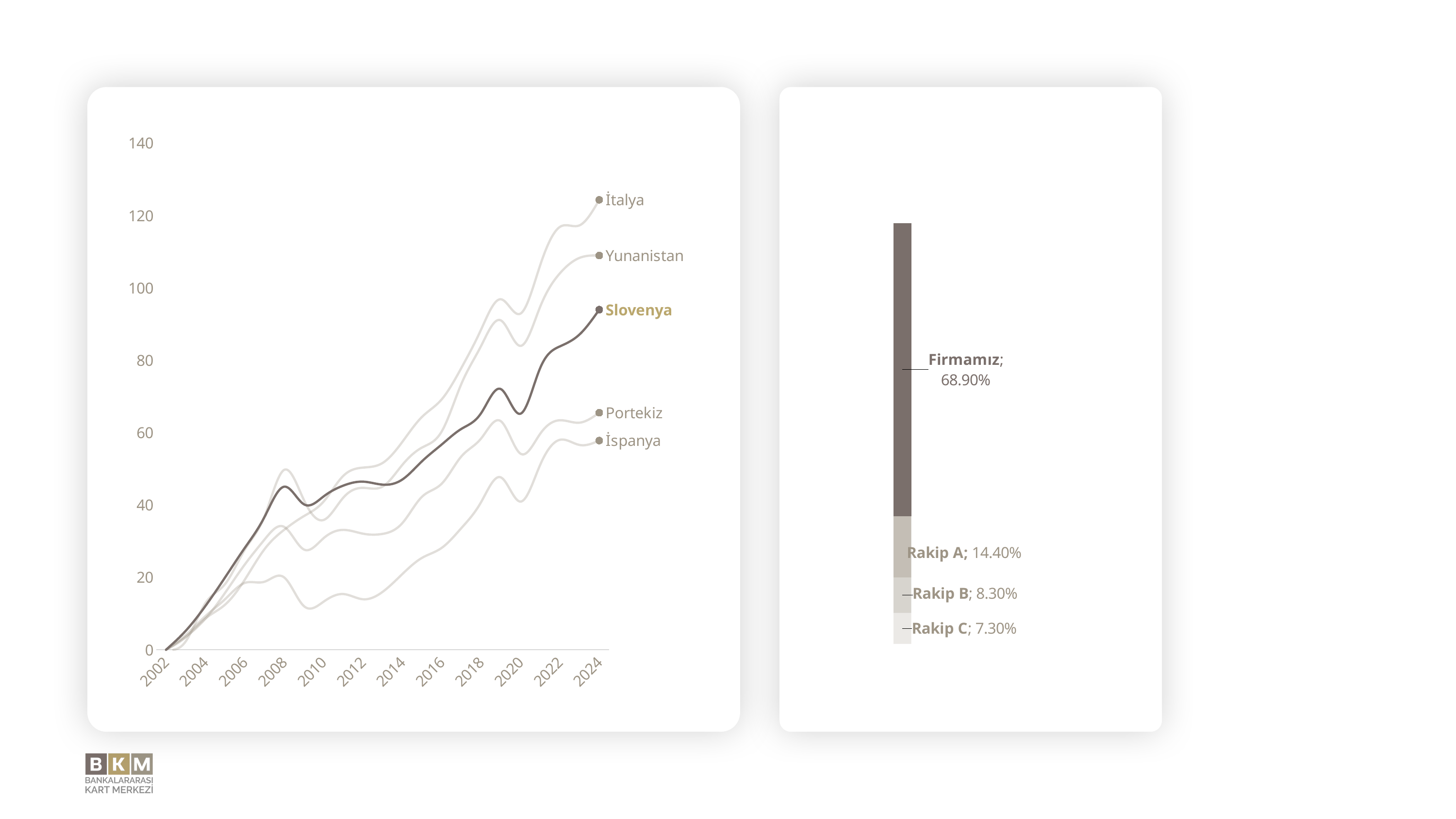
On the right stacked bar chart, what is the value for Rakip B? 8.30% How many series are plotted on the left line chart? 5 On the right stacked bar chart, what is the value for Firmamız? 68.90% On the right stacked bar chart, which segment is the smallest? Rakip C On the left line chart, which series has the highest value in 2024? İtalya What kind of chart is the chart on the left of the slide? line chart On the left line chart, is the value for Portekiz in 2024 greater or less than 60? greater On the left line chart, do the values for Slovenya generally rise or fall from 2002 to 2024? rise On the left line chart, is the value for İtalya in 2024 greater or less than 100? greater On the left line chart, is the value for Slovenya in 2024 greater or less than 100? less On the left line chart, which series has the lowest value in 2024? İspanya On the right stacked bar chart, what is the difference between Firmamız and Rakip A? 54.50%